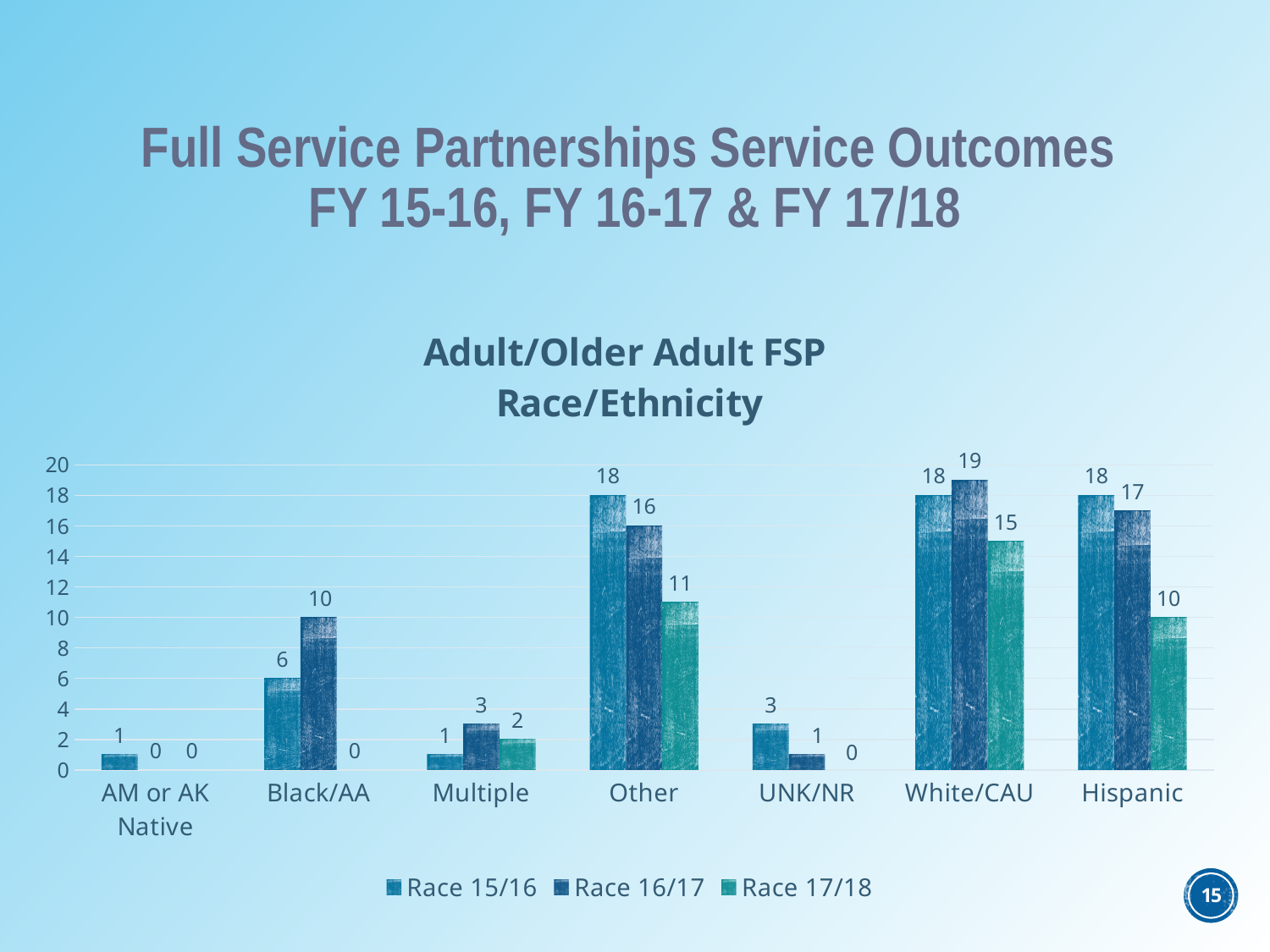
How many series does the legend list? 3 What is the difference between the Race 15/16 and Race 17/18 values for Hispanic? 8 What kind of chart is shown on the slide? Bar chart Which category has the highest Race 17/18 value? White/CAU What is the Race 17/18 value for Other? 11 Which is larger, the Race 16/17 value for White/CAU or the Race 16/17 value for Hispanic? White/CAU What is the difference between the Race 16/17 and Race 17/18 values for Other? 5 How many race/ethnicity categories are shown on the x axis? 7 What is the Race 16/17 value for Black/AA? 10 Which category has the highest Race 16/17 value? White/CAU What is the title of the chart? Adult/Older Adult FSP Race/Ethnicity What is the Race 15/16 value for UNK/NR? 3